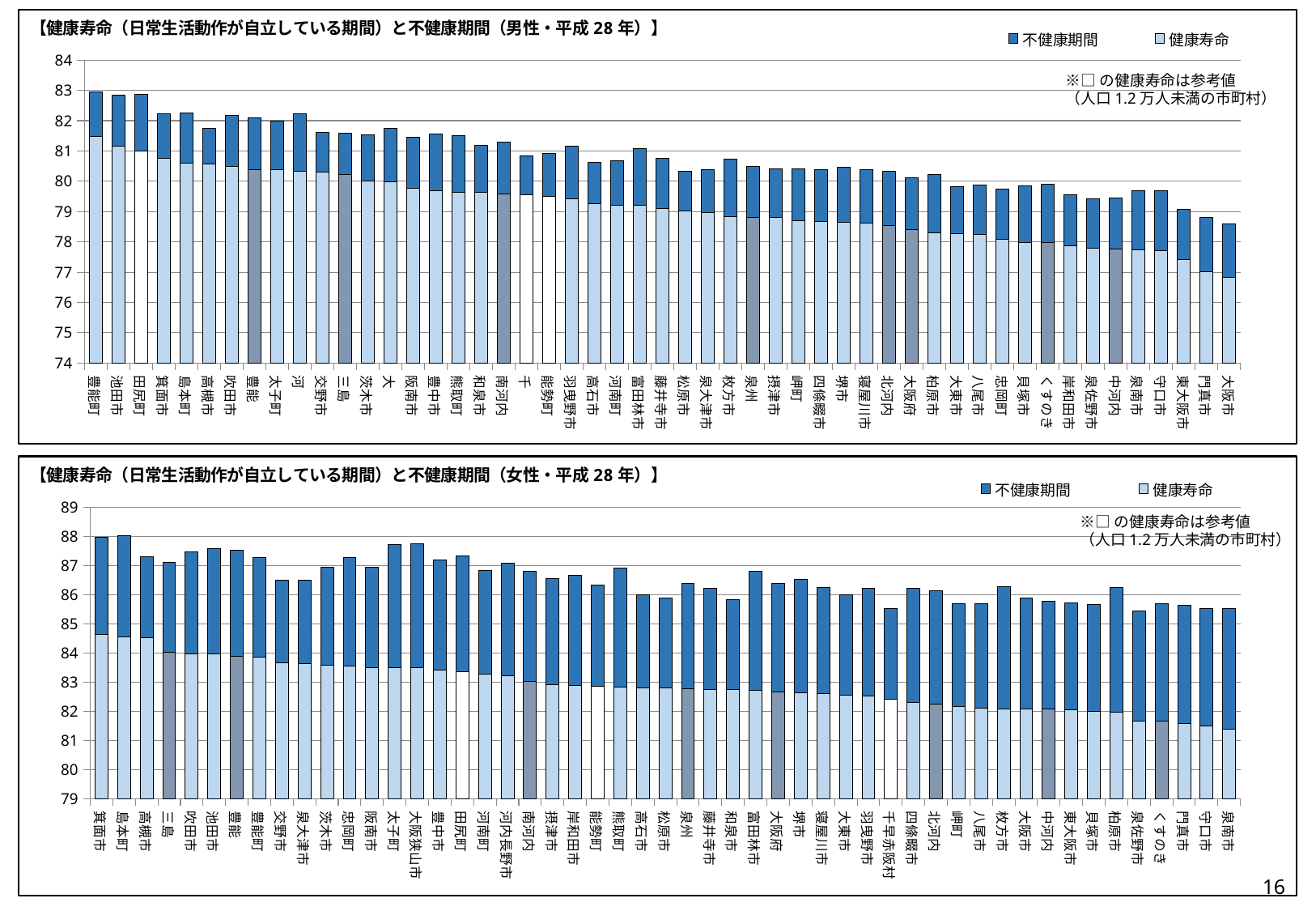
Which year do both chart titles refer to? 平成28年 In the bottom chart (女性・平成28年), is the total bar height for 高槻市 greater or less than 87? greater In the bottom chart (女性・平成28年), is the total bar height for 泉南市 greater or less than 85? greater In the top chart (男性・平成28年), which category has the lowest total bar? 大阪市 In the top chart (男性・平成28年), is the total bar height for 豊能町 greater or less than 82? greater What kind of chart is the top chart (男性・平成28年)? stacked bar chart In the top chart (男性・平成28年), do the total bar heights generally rise or fall from left to right? fall In the top chart (男性・平成28年), which has the taller total bar, 豊能町 or 大阪市? 豊能町 In the top chart (男性・平成28年), what are the two series named in the legend? 不健康期間 and 健康寿命 How many series does the legend of the bottom chart (女性・平成28年) list? 2 In the bottom chart (女性・平成28年), which has the taller total bar, 箕面市 or 泉南市? 箕面市